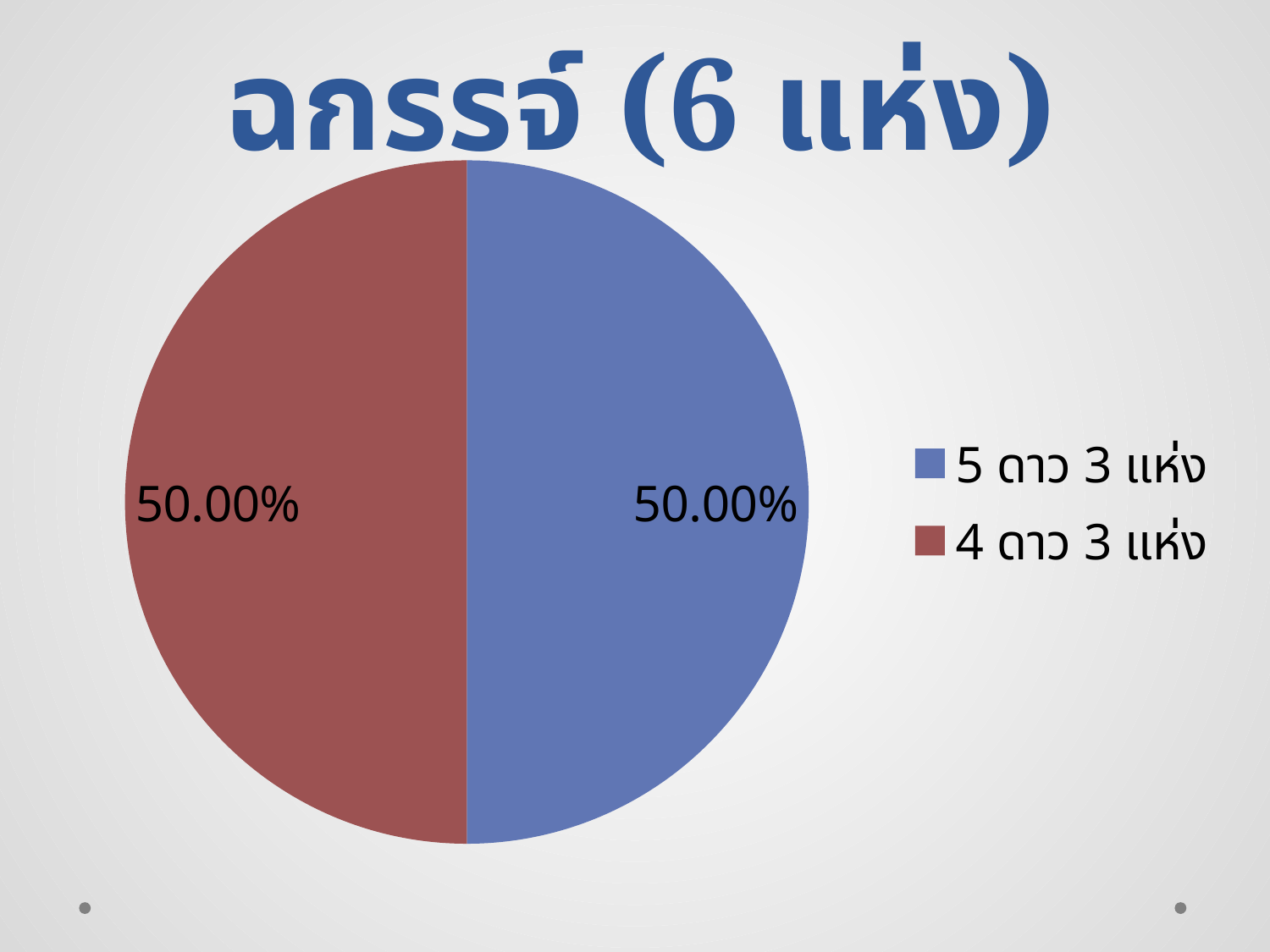
How many slices does the pie chart have? 2 What kind of chart is shown on the slide? pie chart What is the difference between the percentages for 5 ดาว 3 แห่ง and 4 ดาว 3 แห่ง? 0.00% What share of the pie does the 4 ดาว 3 แห่ง slice take? 50.00% What is the title of the chart? ฉกรรจ์ (6 แห่ง) Which colour represents 5 ดาว 3 แห่ง in the pie chart? blue What percentage is shown for the slice labelled 4 ดาว 3 แห่ง? 50.00% What share of the pie does the 5 ดาว 3 แห่ง slice take? 50.00% How many entries does the legend list? 2 Is the value for 4 ดาว 3 แห่ง greater or less than 40%? greater What percentage is shown for the slice labelled 5 ดาว 3 แห่ง? 50.00%